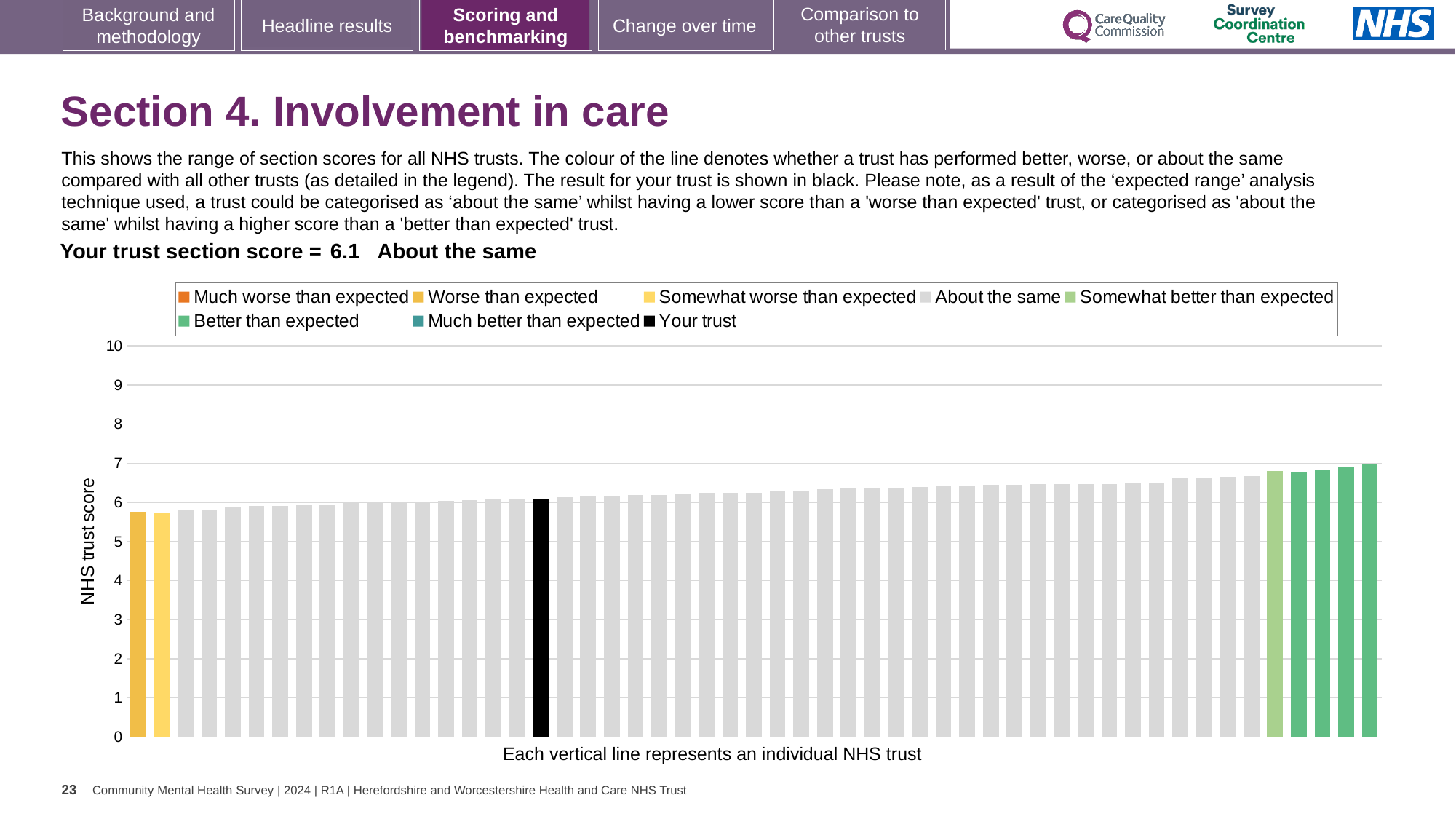
Is the value for the rightmost bar greater or less than 6? greater How many entries does the chart legend list? 8 What colour is the bar representing your trust? black Is the value for the lowest bar in the chart greater or less than 5? greater Is the value for your trust (the black bar) greater or less than 5? greater What is the highest value shown on the y axis? 10 What is the section score for your trust shown on the slide? 6.1 Do the bar values rise or fall from left to right along the x axis? rise What kind of chart is shown on the slide? bar chart Which category is your trust placed in for this section? About the same